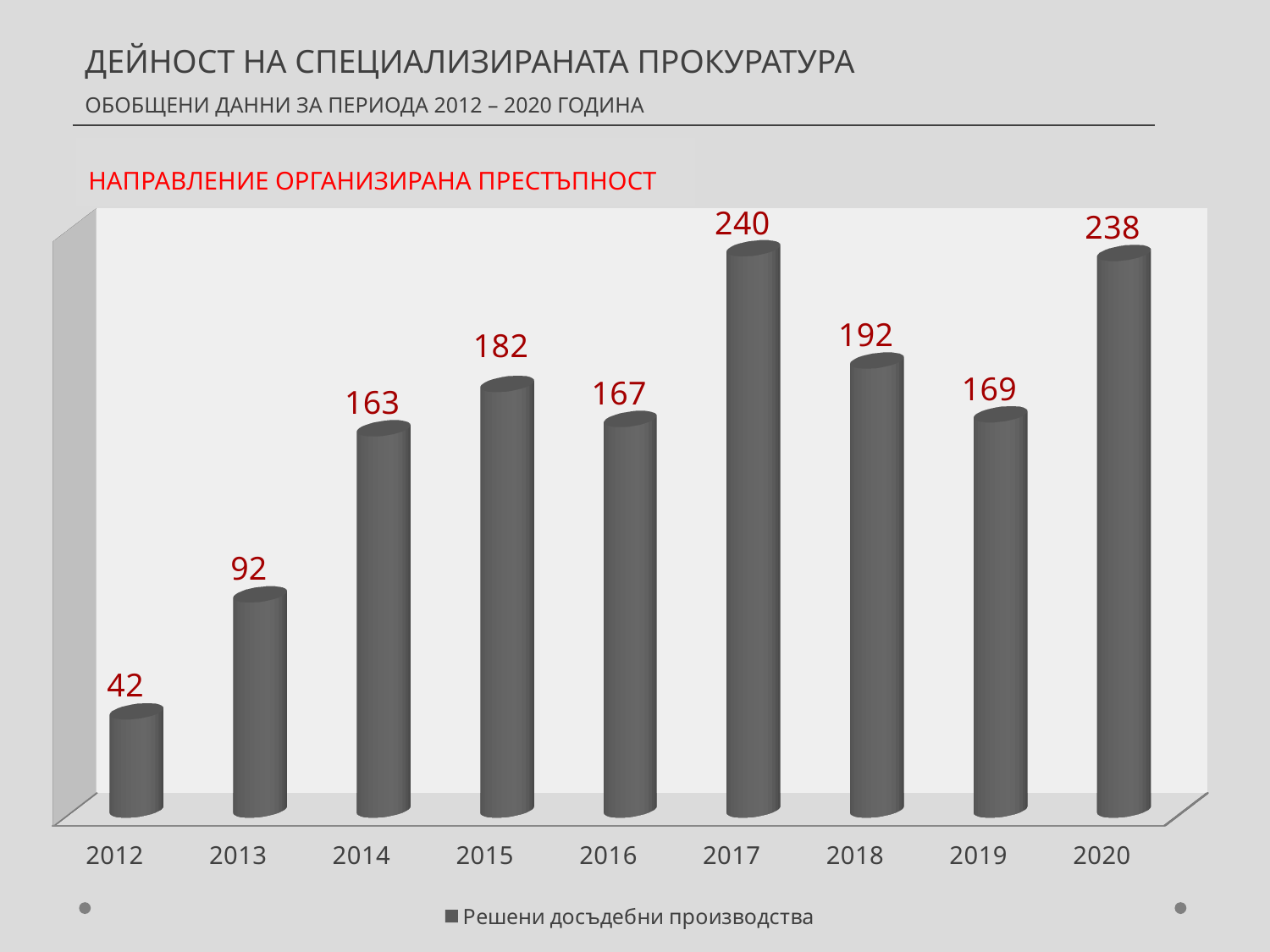
Which year has the lowest value? 2012 What is the value for 2019? 169 What is the difference between the values for 2018 and 2019? 23 What kind of chart is shown? bar chart What is the legend entry of the chart? Решени досъдебни производства How many series does the legend list? 1 Which year has the highest value? 2017 Which is larger, the value for 2015 or the value for 2016? 2015 What is the value for 2012? 42 How many years are shown on the x axis? 9 What is the difference between the values for 2020 and 2012? 196 What is the value for 2017? 240